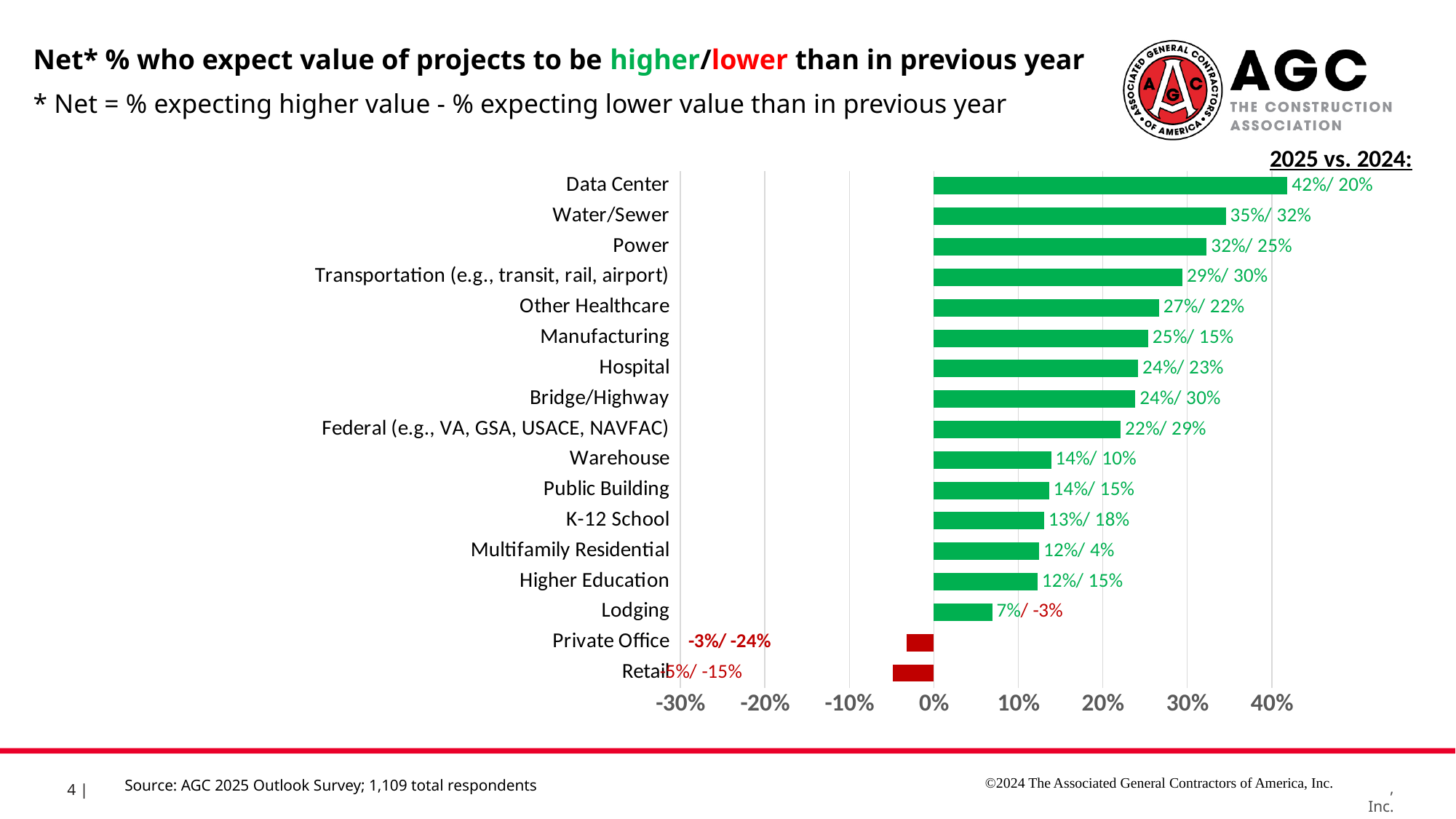
What is the 2024 net % for Private Office? -24% What colour are the bars for categories with a negative 2025 net %? Red Which has a higher 2025 net %: Manufacturing or Warehouse? Manufacturing What is the 2025 net % for Data Center? 42% Which category has the lowest 2024 net %? Private Office What kind of chart is shown on the slide? Bar chart What is the difference between the 2025 and 2024 net % for Data Center? 22 percentage points How many categories are shown in the chart? 17 Which category has the highest 2025 net %? Data Center What is the 2025 net % for Multifamily Residential? 12% What is the 2024 net % for Bridge/Highway? 30% Is the 2025 net % for Water/Sewer greater or less than 30%? greater